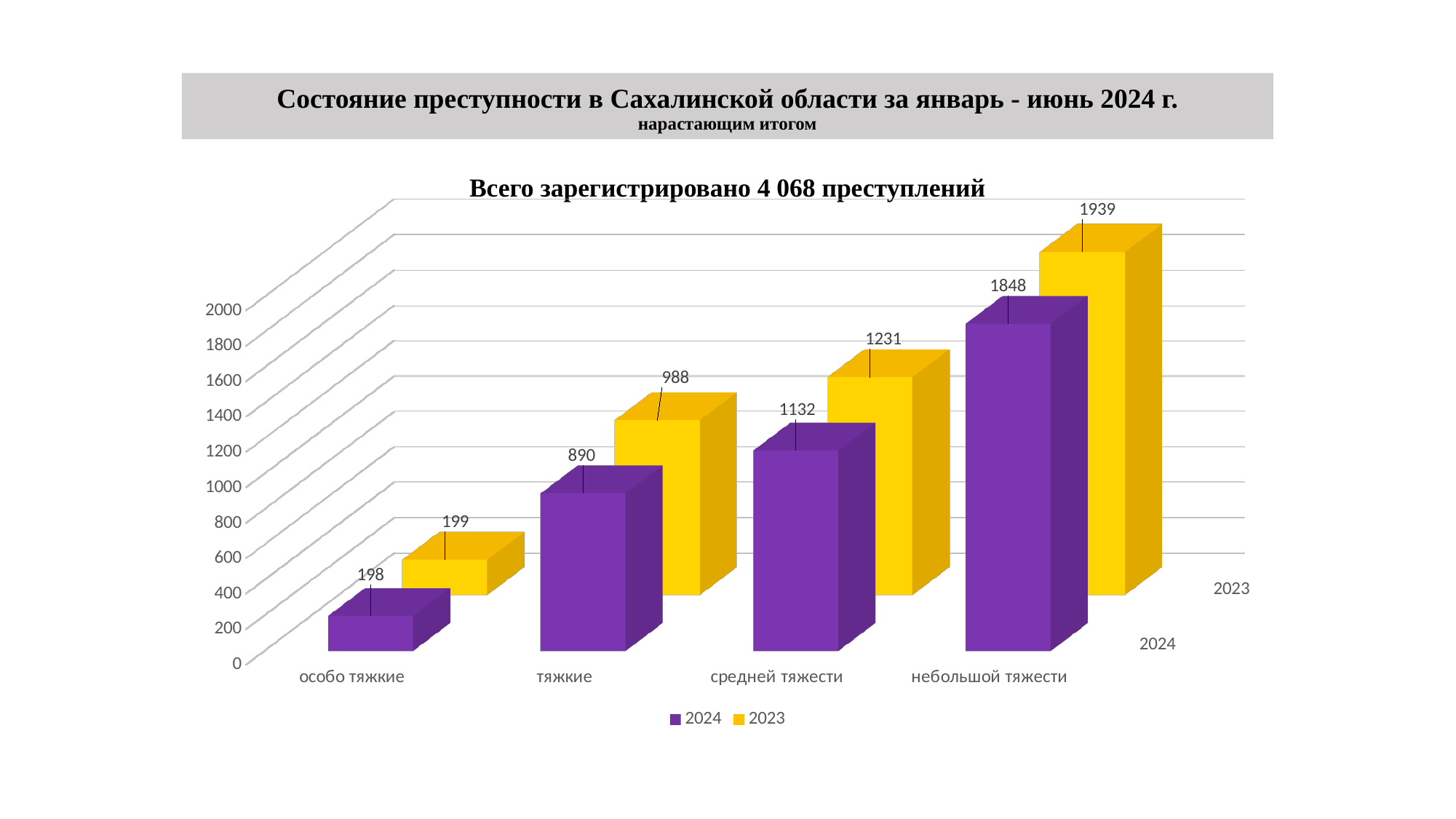
What kind of chart is shown on the slide? bar chart Which category has the highest value in the 2024 series? небольшой тяжести What is the value for "небольшой тяжести" in the 2023 series? 1939 How many series does the legend list? 2 Which is larger for "средней тяжести": the 2024 value or the 2023 value? 2023 How many categories are shown on the x axis? 4 What is the difference between the 2023 and 2024 values for "тяжкие"? 98 What is the value for "особо тяжкие" in the 2023 series? 199 What is the value for "средней тяжести" in the 2024 series? 1132 Which category has the lowest value in the 2023 series? особо тяжкие What total number of registered crimes is stated in the chart title? 4 068 What is the value for "тяжкие" in the 2024 series? 890